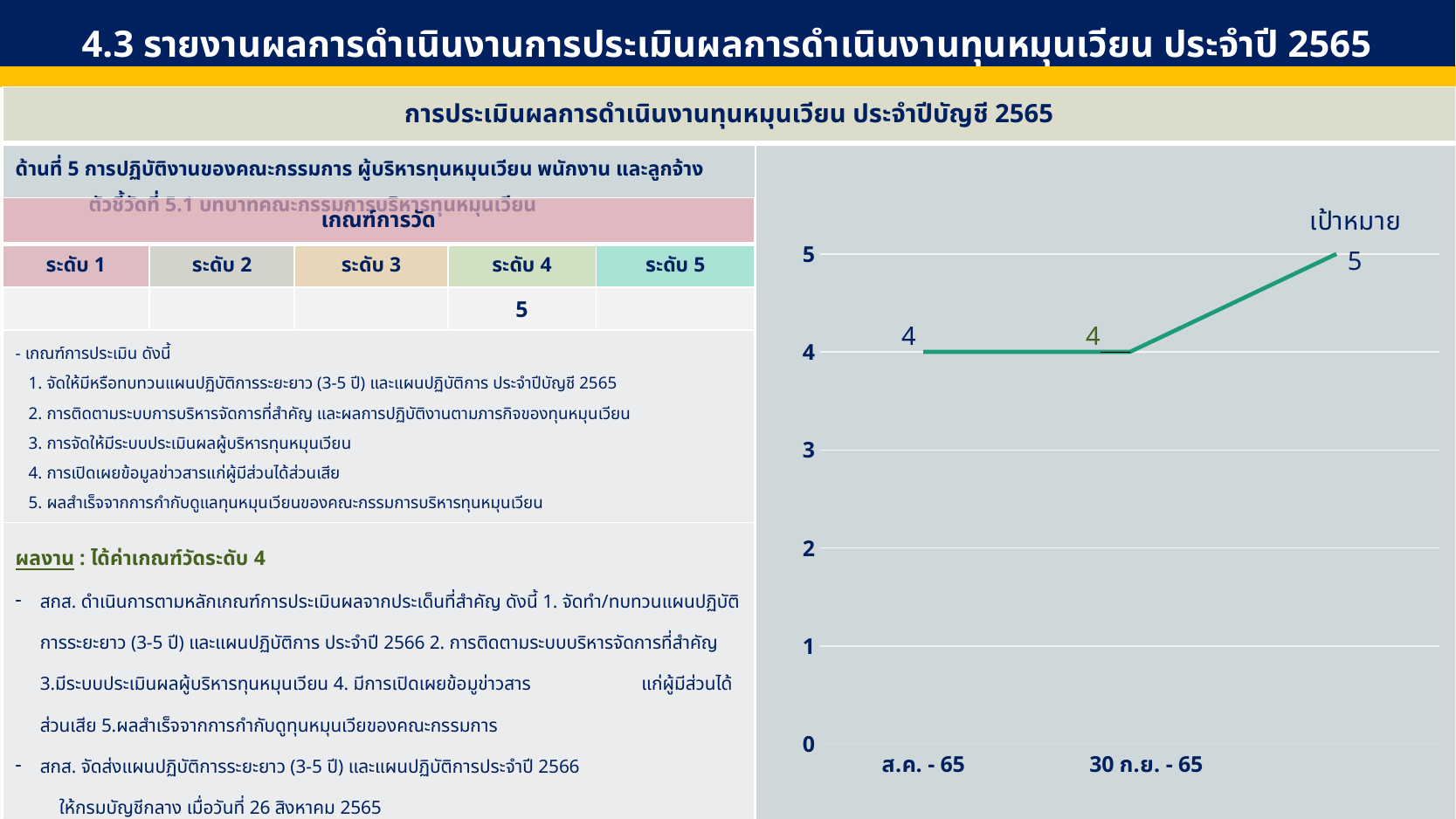
Which point on the line has the highest value? เป้าหมาย What is the highest value shown on the vertical axis of the chart? 5 What type of chart is shown on the right side of the slide? line chart What is the value plotted for เป้าหมาย? 5 What is the value plotted for ส.ค. - 65? 4 How many data points are plotted on the line? 3 What is the difference between the value for เป้าหมาย and the value for 30 ก.ย. - 65? 1 What colour is the plotted line in the chart? green What is the value plotted for 30 ก.ย. - 65? 4 Does the line rise or fall between 30 ก.ย. - 65 and เป้าหมาย? rises Which is larger, the value for เป้าหมาย or the value for ส.ค. - 65? เป้าหมาย Does the line rise, fall, or stay flat between ส.ค. - 65 and 30 ก.ย. - 65? stays flat